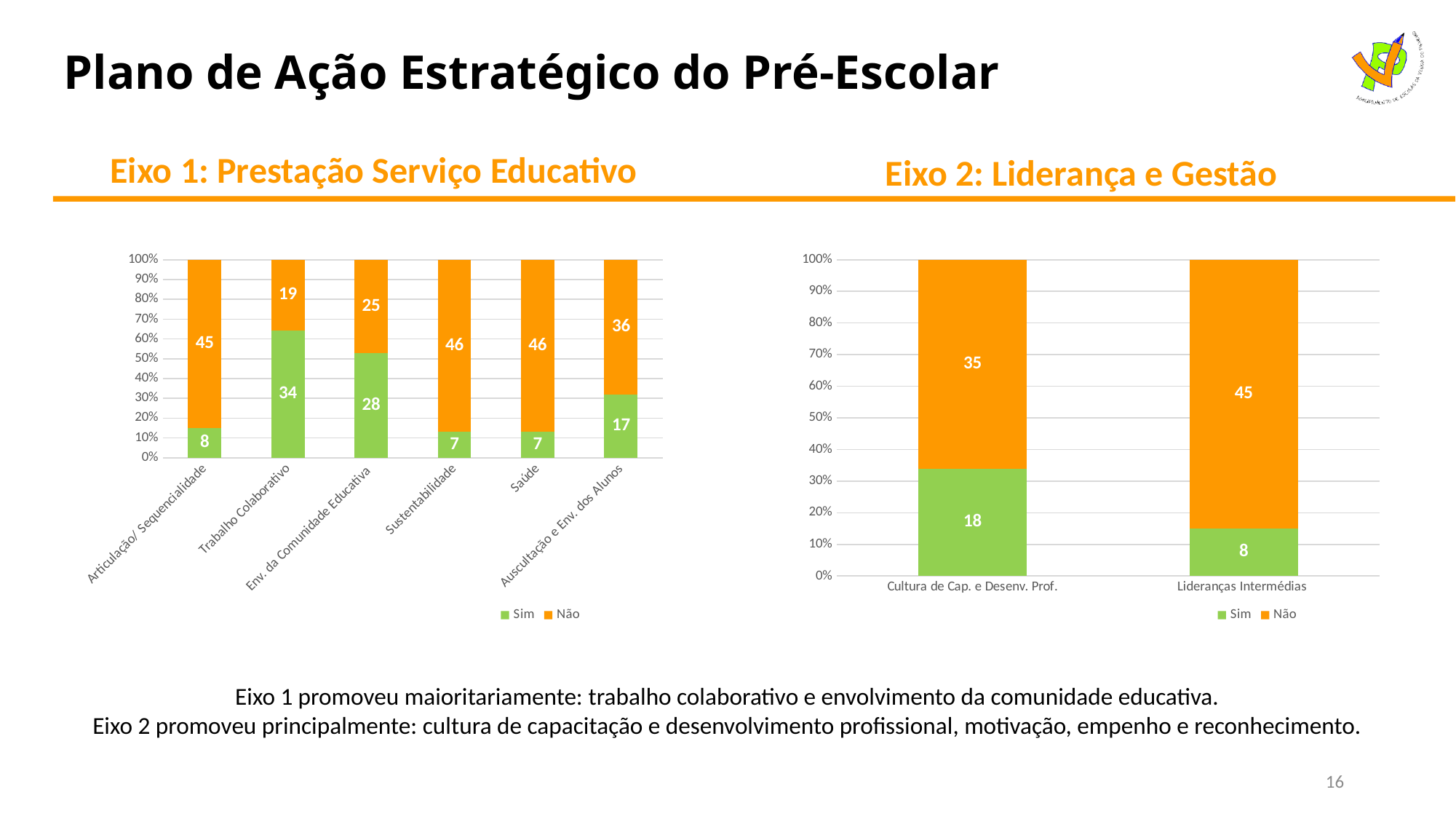
In the Eixo 1: Prestação Serviço Educativo chart, which category has the highest 'Sim' value? Trabalho Colaborativo In the Eixo 2: Liderança e Gestão chart, what is the 'Sim' value for Lideranças Intermédias? 8 In the Eixo 2: Liderança e Gestão chart, what is the total of the stacked bar for Cultura de Cap. e Desenv. Prof.? 53 In the Eixo 1: Prestação Serviço Educativo chart, what is the difference between the 'Não' and 'Sim' values for Articulação/ Sequencialidade? 37 In the Eixo 2: Liderança e Gestão chart, which category has the larger 'Não' value, Cultura de Cap. e Desenv. Prof. or Lideranças Intermédias? Lideranças Intermédias In the Eixo 1: Prestação Serviço Educativo chart, is the 'Sim' share for Env. da Comunidade Educativa greater or less than 40%? greater In the Eixo 1: Prestação Serviço Educativo chart, what is the total of the stacked bar for Auscultação e Env. dos Alunos? 53 In the Eixo 1: Prestação Serviço Educativo chart, what is the 'Não' value for Sustentabilidade? 46 In the Eixo 2: Liderança e Gestão chart, how many series does the legend list? 2 In the Eixo 1: Prestação Serviço Educativo chart, what is the 'Sim' value for Trabalho Colaborativo? 34 In the Eixo 1: Prestação Serviço Educativo chart, how many categories are shown on the x axis? 6 What kind of chart is the Eixo 2: Liderança e Gestão chart? Stacked bar chart